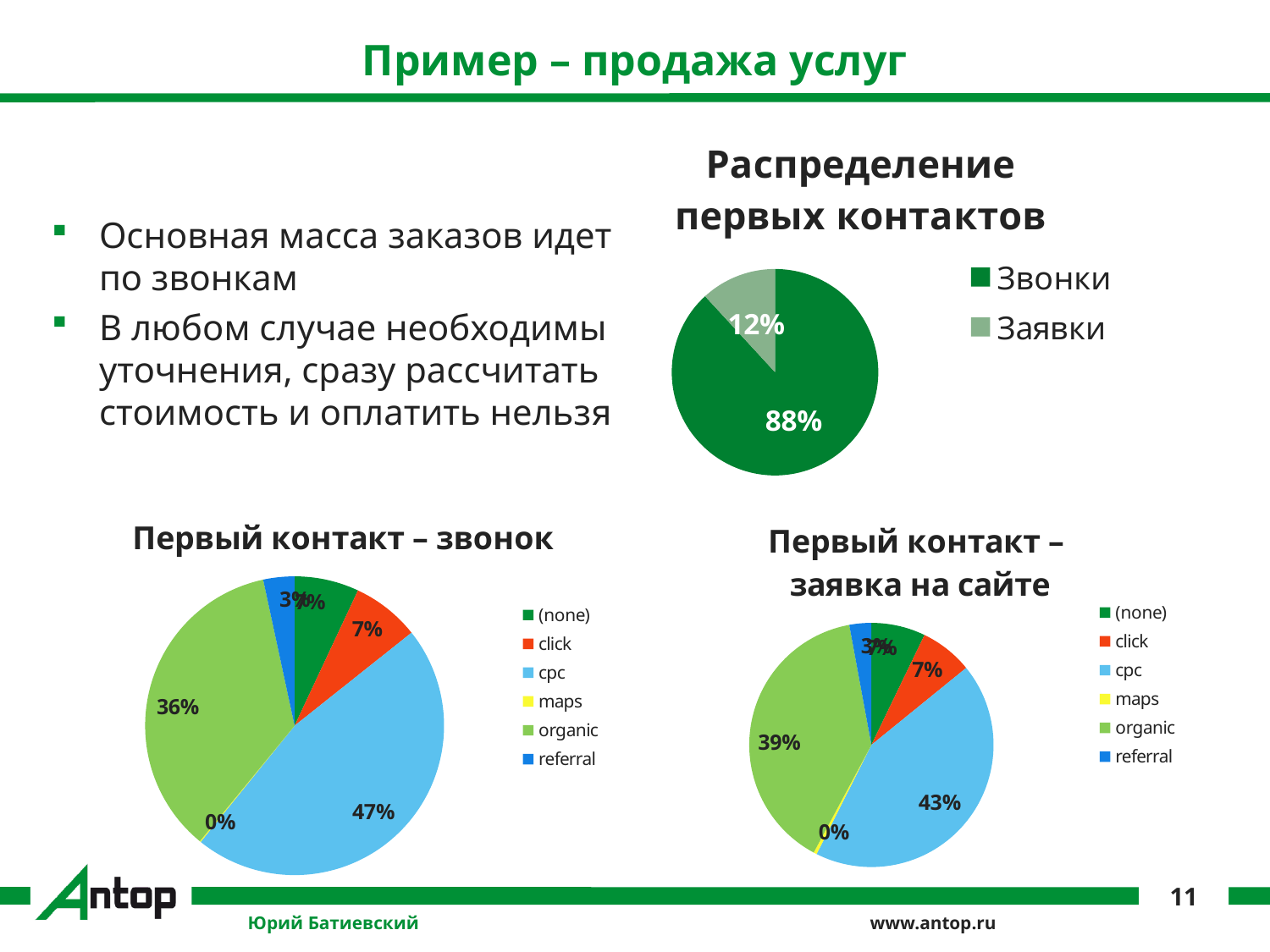
In the chart titled 'Первый контакт – звонок', how many categories does the legend list? 6 In the chart titled 'Первый контакт – заявка на сайте', what share is labelled for cpc? 43% In the chart titled 'Распределение первых контактов', which category has the larger share? Звонки What kind of chart is 'Распределение первых контактов'? pie chart In the chart titled 'Первый контакт – звонок', which category has the largest share? cpc In the chart titled 'Распределение первых контактов', what share is labelled for Заявки? 12% In the chart titled 'Первый контакт – заявка на сайте', which is larger, the share for cpc or the share for click? cpc In the chart titled 'Первый контакт – звонок', what share is labelled for organic? 36% In the chart titled 'Первый контакт – заявка на сайте', what share is labelled for organic? 39% In the chart titled 'Первый контакт – звонок', what share is labelled for cpc? 47% In the chart titled 'Распределение первых контактов', what share is labelled for Звонки? 88% In the chart titled 'Распределение первых контактов', what is the difference between the Звонки and Заявки shares? 76%